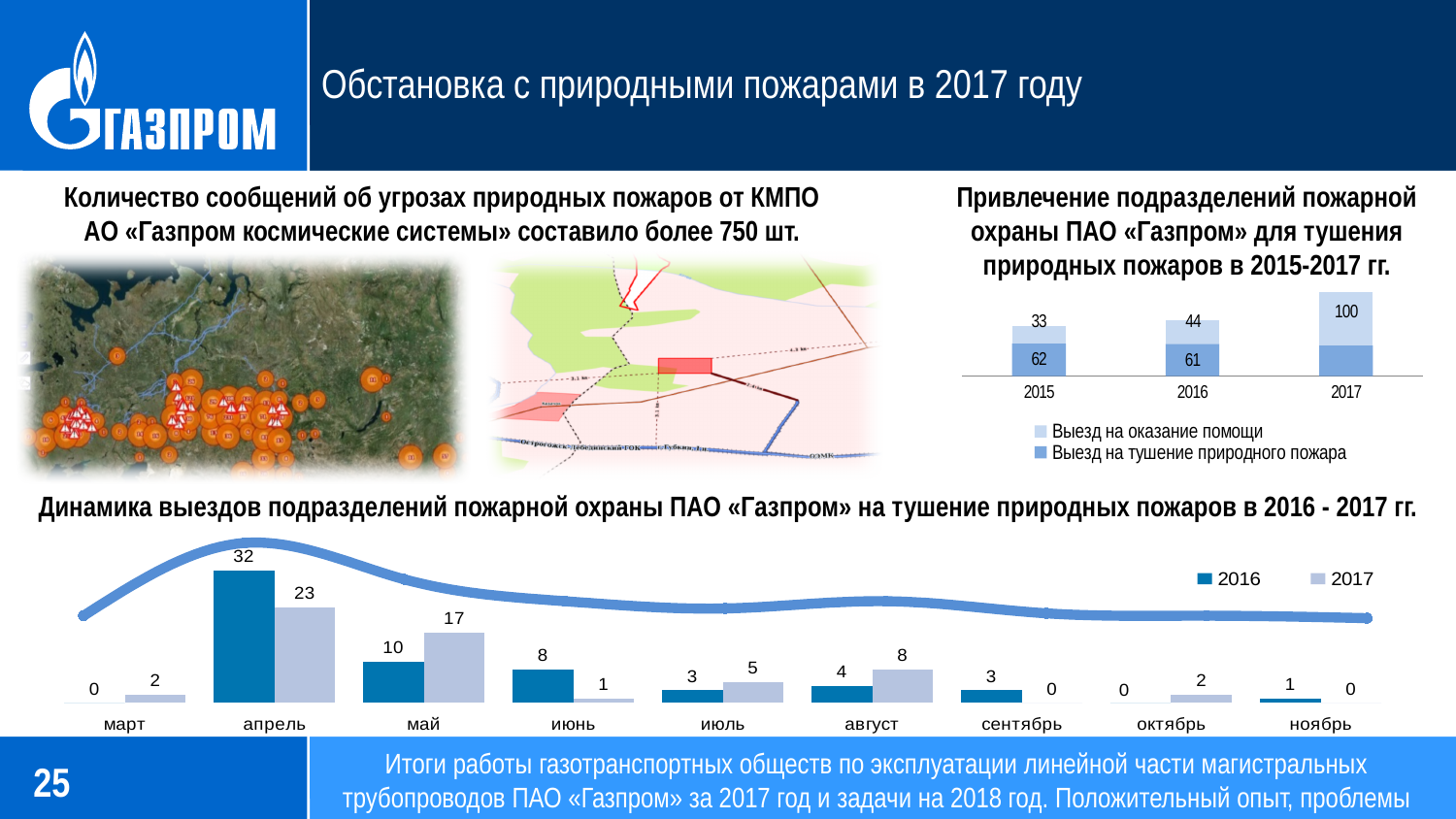
In the bottom chart 'Динамика выездов подразделений пожарной охраны ПАО «Газпром» на тушение природных пожаров в 2016 - 2017 гг.', what is the value for 2016 in апрель? 32 What type of chart is the top-right chart 'Привлечение подразделений пожарной охраны ПАО «Газпром»...'? Stacked bar chart In the top-right chart 'Привлечение подразделений пожарной охраны ПАО «Газпром»...', what is the total of the stacked bar for 2016? 105 In the bottom chart 'Динамика выездов...', how many months are shown on the x axis? 9 In the bottom chart 'Динамика выездов...', what is the value for 2017 in июнь? 1 In the bottom chart 'Динамика выездов...', what is the value for 2017 in май? 17 In the top-right chart 'Привлечение подразделений пожарной охраны ПАО «Газпром»...', what is the value of 'Выезд на тушение природного пожара' for 2015? 62 In the bottom chart 'Динамика выездов...', how many series does the legend list? 2 In the bottom chart 'Динамика выездов...', which is larger in август: the 2016 value or the 2017 value? 2017 In the bottom chart 'Динамика выездов...', which month has the highest value for 2016? апрель In the top-right chart 'Привлечение подразделений пожарной охраны ПАО «Газпром»...', what is the value of 'Выезд на оказание помощи' for 2017? 100 In the bottom chart 'Динамика выездов...', what is the difference between the 2016 and 2017 values in апрель? 9